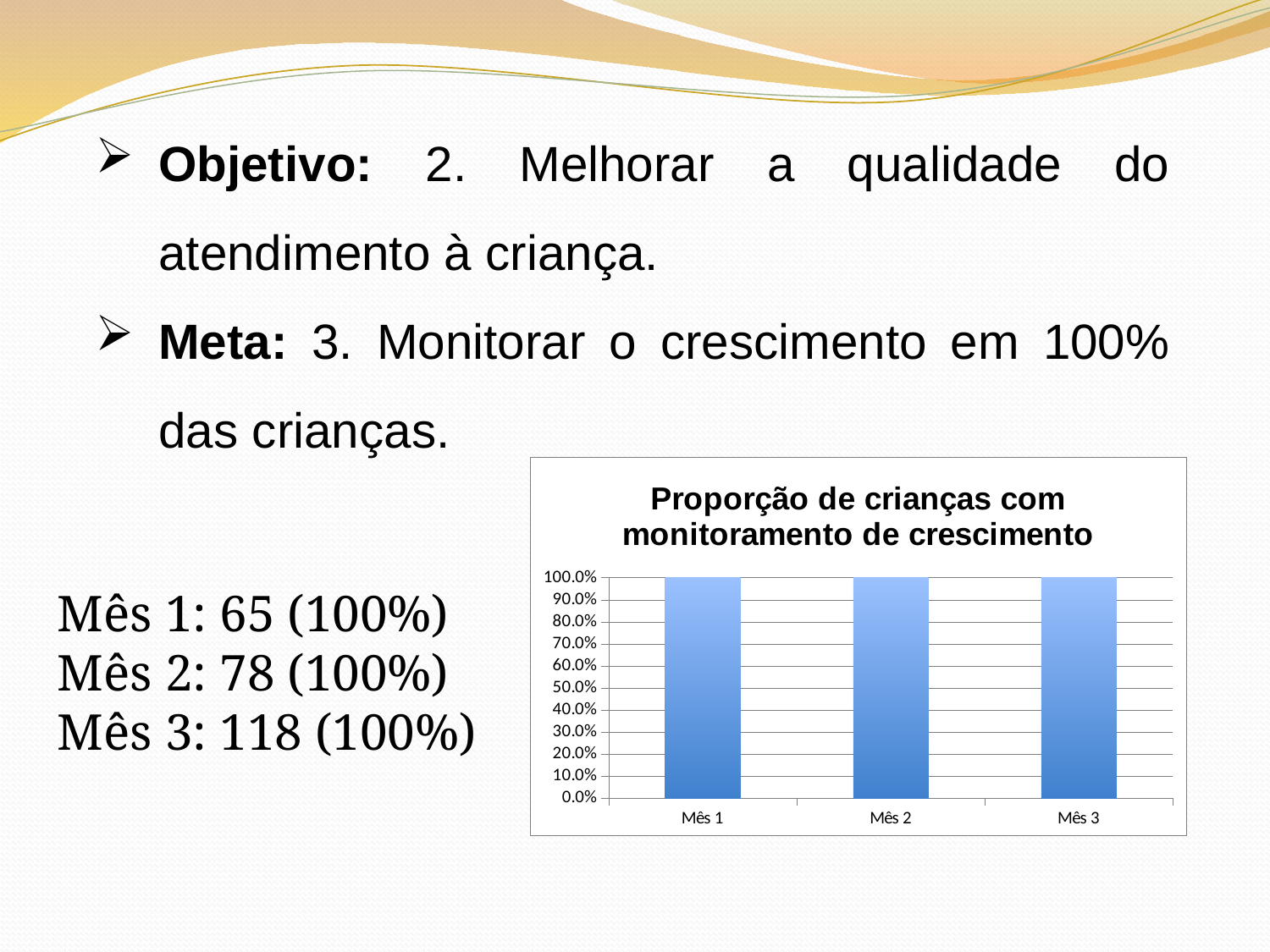
What is the label of the first category on the x axis? Mês 1 What is the value for Mês 3 in the chart? 100.0% Do the values rise, fall, or stay the same from Mês 1 to Mês 3? stay the same What is the difference between the values for Mês 1 and Mês 3? 0.0% Is the value for Mês 3 greater or less than 90.0%? greater Is the value for Mês 2 greater or less than 50.0%? greater What is the value for Mês 1 in the chart? 100.0% What is the value for Mês 2 in the chart? 100.0% What type of chart is shown on the slide? bar chart What is the title of the chart? Proporção de crianças com monitoramento de crescimento How many categories are shown on the x axis of the chart? 3